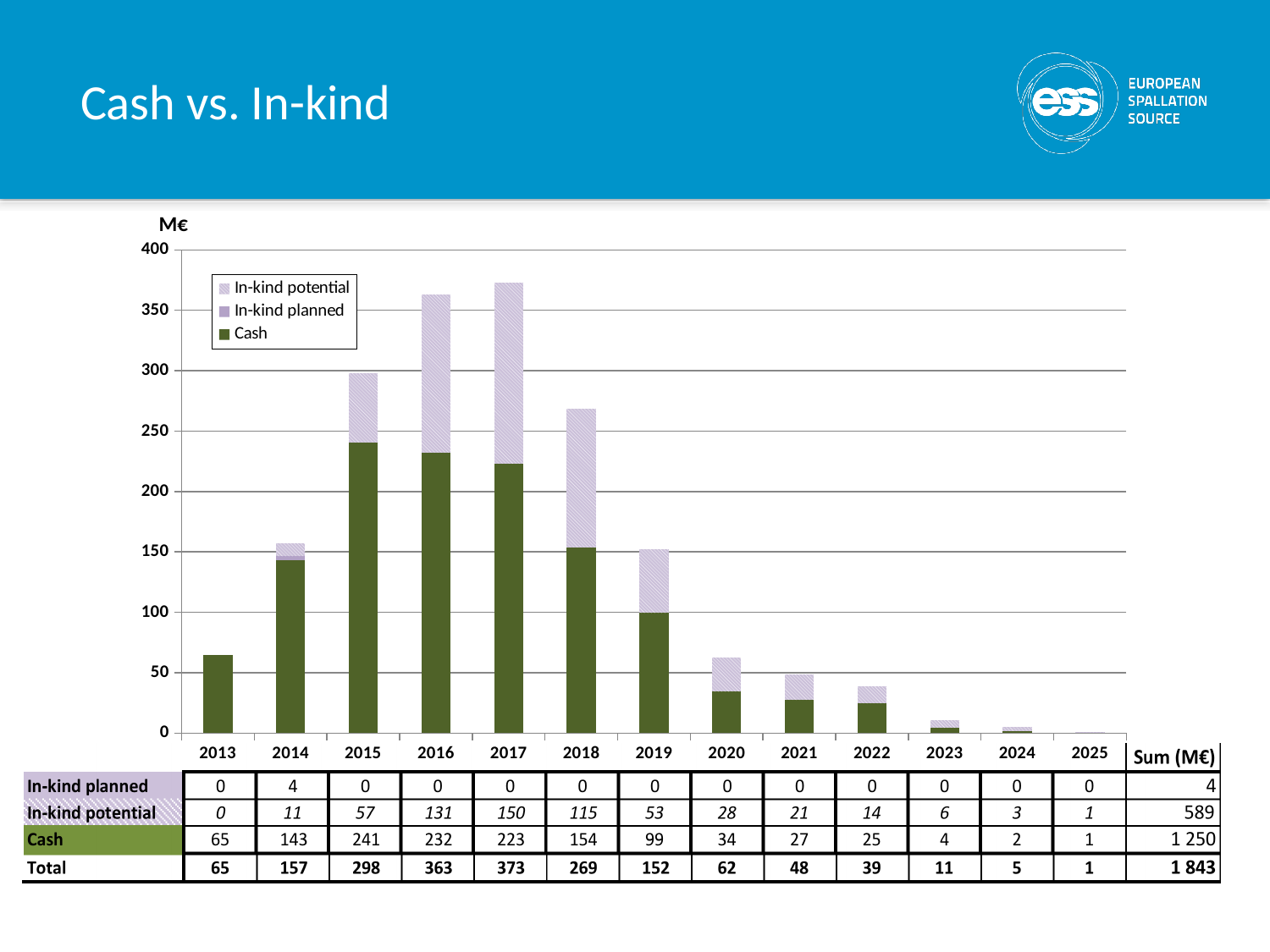
Which year has the highest total? 2017 What is the Cash value for 2015? 241 How many years are shown on the x axis? 13 What is the difference between the Cash values for 2015 and 2016? 9 Which year has the lowest total? 2025 Do the totals rise or fall from 2018 to 2025? Fall What is the In-kind potential value for 2017? 150 What is the In-kind planned value for 2014? 4 How many series does the legend list? 3 What kind of chart is shown? Stacked bar chart Which is larger, the Cash value for 2018 or the Cash value for 2019? 2018 What is the total of the stacked bar for 2016? 363